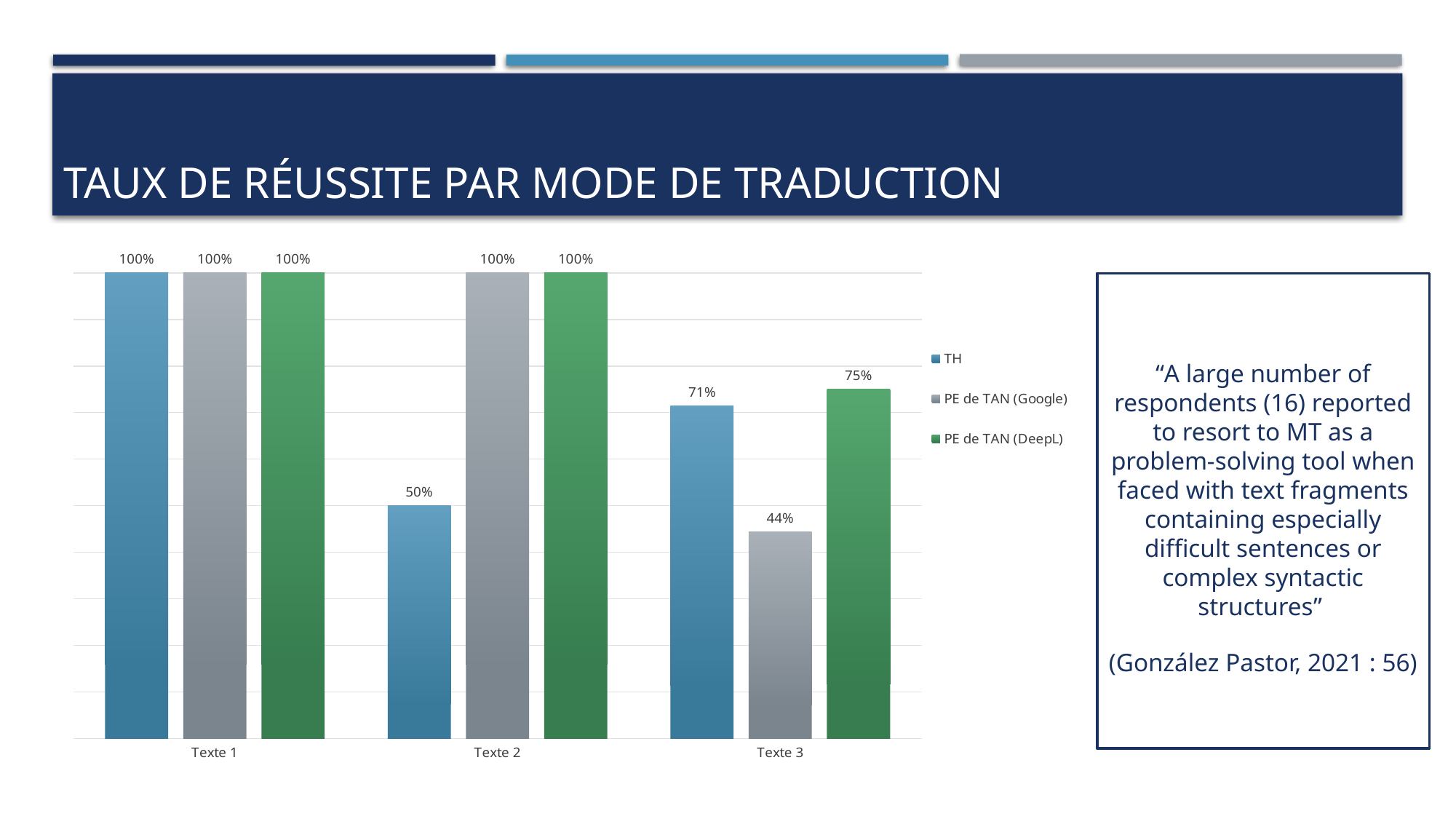
What is the value for PE de TAN (DeepL) for Texte 3? 75% What is the difference between the TH values for Texte 2 and Texte 3? 21% How many series does the legend list? 3 What is the value for PE de TAN (Google) for Texte 3? 44% Which is larger for Texte 2: the TH value or the PE de TAN (Google) value? PE de TAN (Google) What is the difference between the PE de TAN (DeepL) and TH values for Texte 3? 4% How many categories are shown on the x axis? 3 What kind of chart is shown on the slide? Bar chart What is the value for TH for Texte 2? 50% What is the value for TH for Texte 3? 71% Which series has the lowest value for Texte 3? PE de TAN (Google) Which series has the highest value for Texte 3? PE de TAN (DeepL)